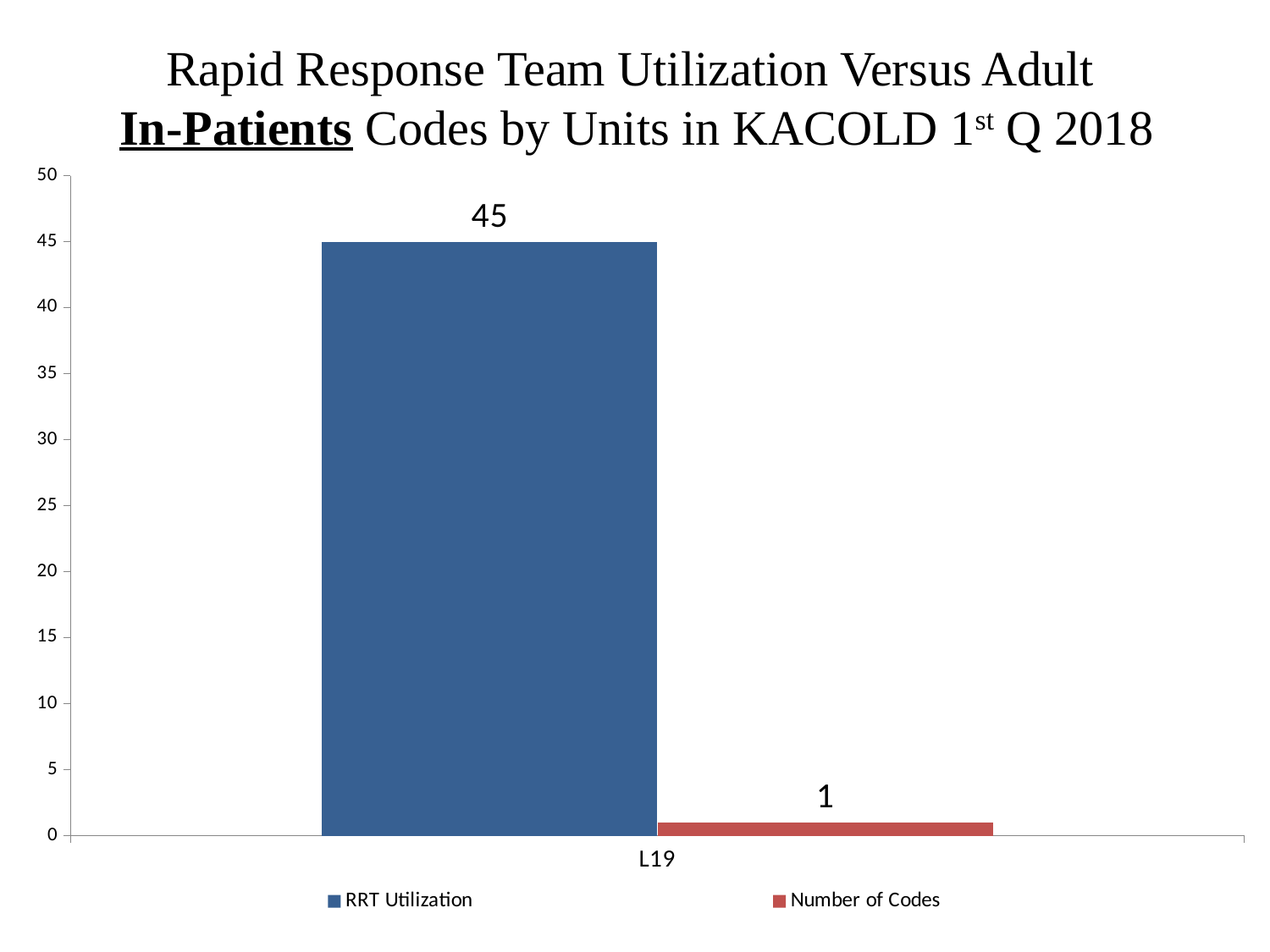
Which unit is shown on the x axis of the chart? L19 Which series has the higher value for L19, RRT Utilization or Number of Codes? RRT Utilization What is the Number of Codes value for L19? 1 Is the RRT Utilization value for L19 greater or less than 40? greater What is the RRT Utilization value for L19? 45 Is the Number of Codes value for L19 greater or less than 5? less How many categories are shown on the x axis? 1 What is the difference between RRT Utilization and Number of Codes for L19? 44 What is the maximum value shown on the y axis? 50 What colour is the bar for Number of Codes? Red How many series does the legend list? 2 What kind of chart is shown on the slide? Bar chart